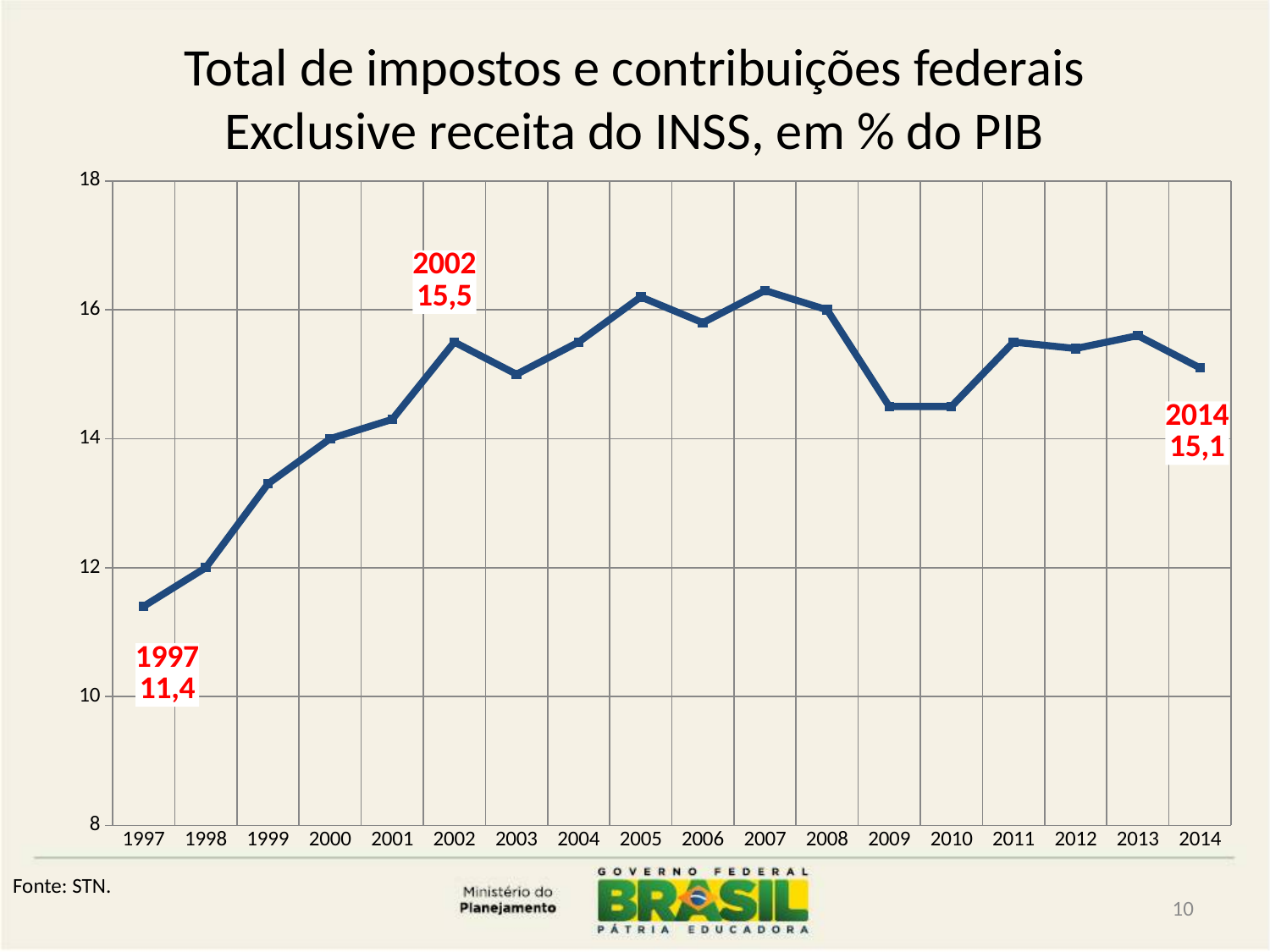
Which is larger, the value for 2002 or the value for 2014? 2002 What is the value for 2002? 15,5 What is the difference between the values for 2002 and 1997? 4,1 Is the value for 2007 greater or less than 16? greater What kind of chart is shown on the slide? line chart Is the value for 1999 greater or less than 14? less What is the value for 2014? 15,1 How many years are plotted on the x axis? 18 What is the value for 1997? 11,4 What is the difference between the values for 2014 and 1997? 3,7 Which year has the lowest value? 1997 Is the value for 2009 greater or less than 16? less